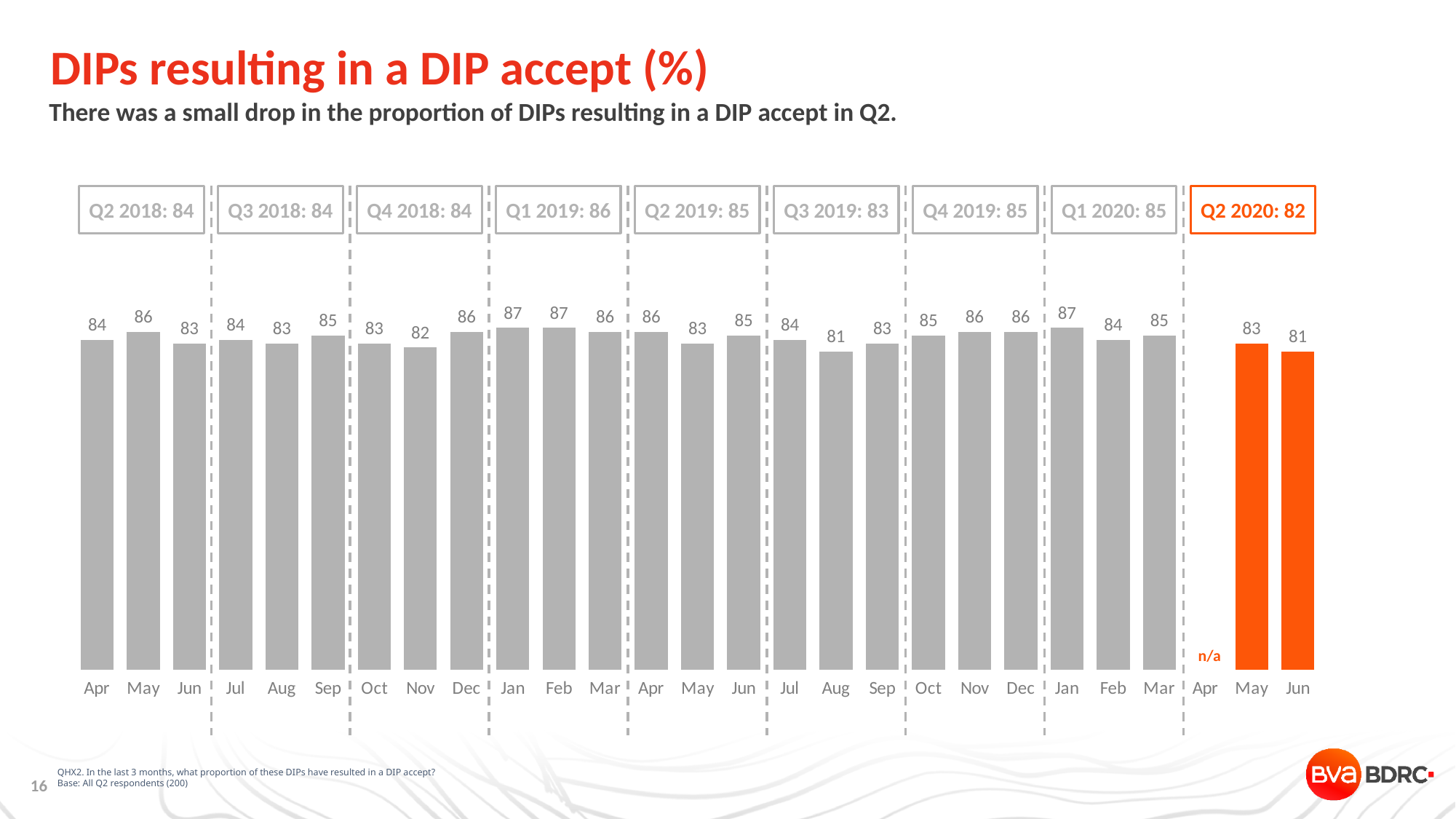
Which is larger, the value for Dec 2018 or the value for Oct 2018? Dec 2018 What is the value for Jun 2020? 81 Which month is shown as n/a on the chart? Apr 2020 Which quarter has the highest quarterly figure? Q1 2019 What kind of chart is shown on the slide? Bar chart What is the value for May 2018? 86 What is the difference between the quarterly figures for Q1 2020 and Q2 2020? 3 Which quarter has the lowest quarterly figure? Q2 2020 What is the difference between the values for Jan 2019 and Nov 2018? 5 What is the value for Aug 2019? 81 What is the highest monthly value shown on the chart? 87 What is the quarterly figure shown for Q2 2020? 82